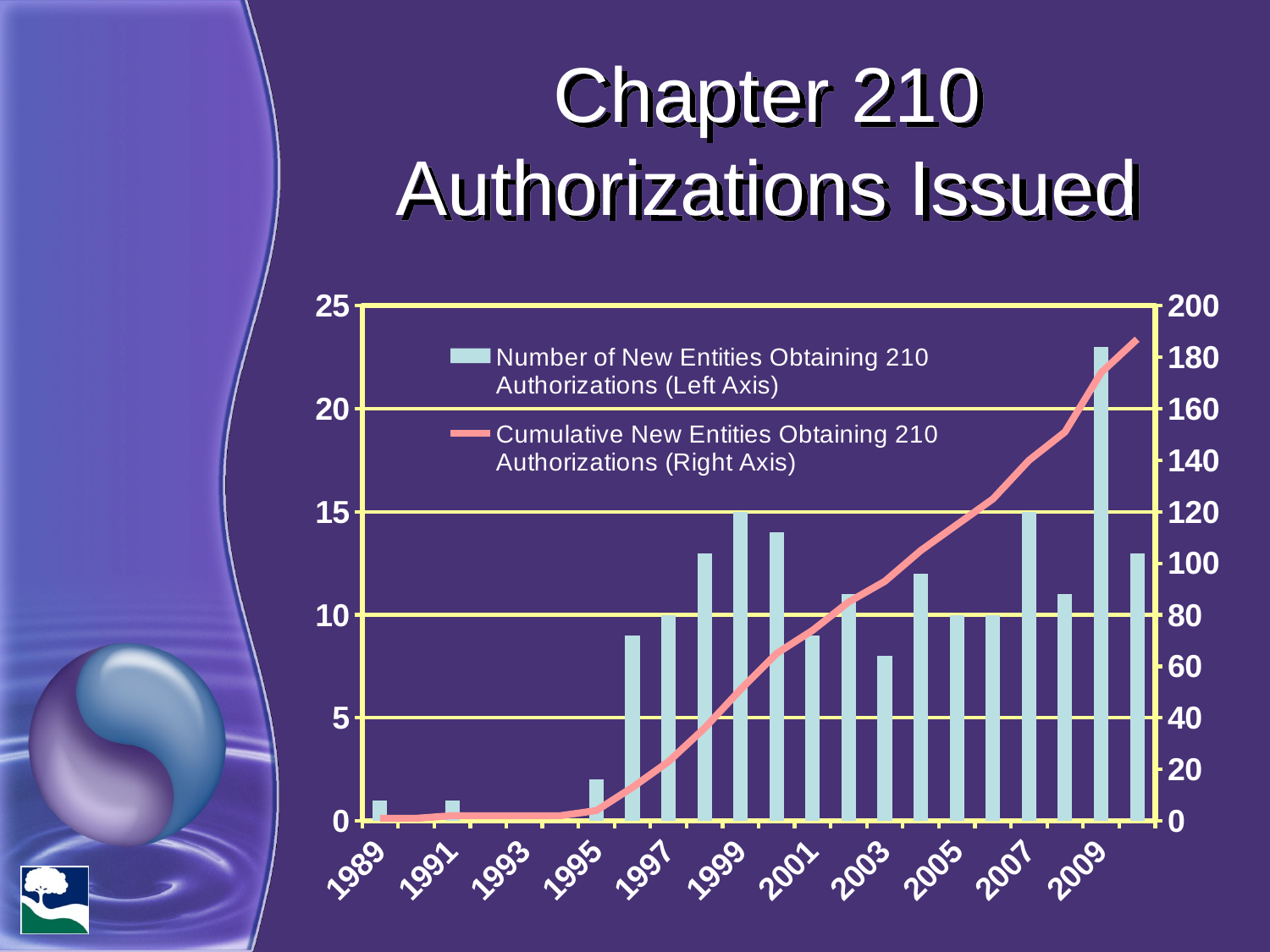
Which year has more new entities obtaining 210 authorizations, 2009 or 2010? 2009 Is the number of new entities obtaining 210 authorizations in 1999 greater or less than 10? greater Which year has more new entities obtaining 210 authorizations, 1999 or 2003? 1999 Is the cumulative number of new entities obtaining 210 authorizations in 2009 greater or less than 160 on the right axis? greater Is the number of new entities obtaining 210 authorizations in 2009 greater or less than 20? greater How many series does the legend list? 2 Does the cumulative number of new entities obtaining 210 authorizations rise or fall from 1989 to 2010? rise Which series is plotted against the right axis? Cumulative New Entities Obtaining 210 Authorizations What kind of chart is this? A combined bar and line chart What is the title of the chart? Chapter 210 Authorizations Issued In which year is the number of new entities obtaining 210 authorizations highest? 2009